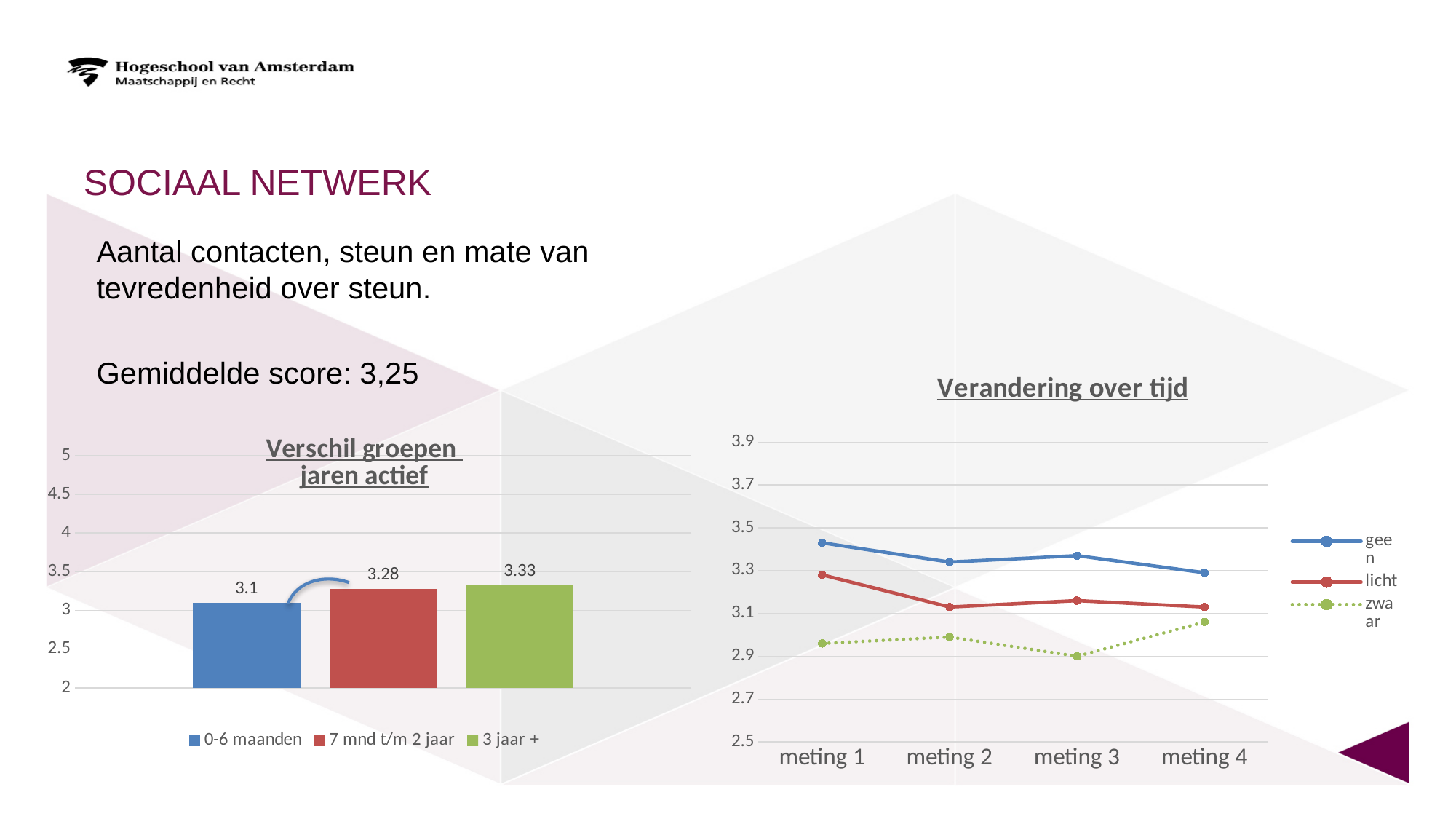
In the 'Verandering over tijd' chart, does the 'geen' series rise or fall from meting 1 to meting 4? Fall In the 'Verschil groepen jaren actief' chart, which group has the lowest value? 0-6 maanden In the 'Verschil groepen jaren actief' chart, what is the value for 3 jaar +? 3.33 In the 'Verandering over tijd' chart, is the value for 'geen' at meting 1 greater or less than 3.3? greater In the 'Verandering over tijd' chart, is the value for 'zwaar' at meting 1 greater or less than 3.1? less In the 'Verschil groepen jaren actief' chart, what is the difference between the values for 3 jaar + and 0-6 maanden? 0.23 In the 'Verschil groepen jaren actief' chart, what is the value for 0-6 maanden? 3.1 In the 'Verandering over tijd' chart, which series is drawn with a dotted line? zwaar In the 'Verandering over tijd' chart, how many series does the legend list? 3 In the 'Verschil groepen jaren actief' chart, how many groups are shown? 3 In the 'Verandering over tijd' chart, which series has the highest value at meting 2? geen What kind of chart is 'Verschil groepen jaren actief'? Bar chart